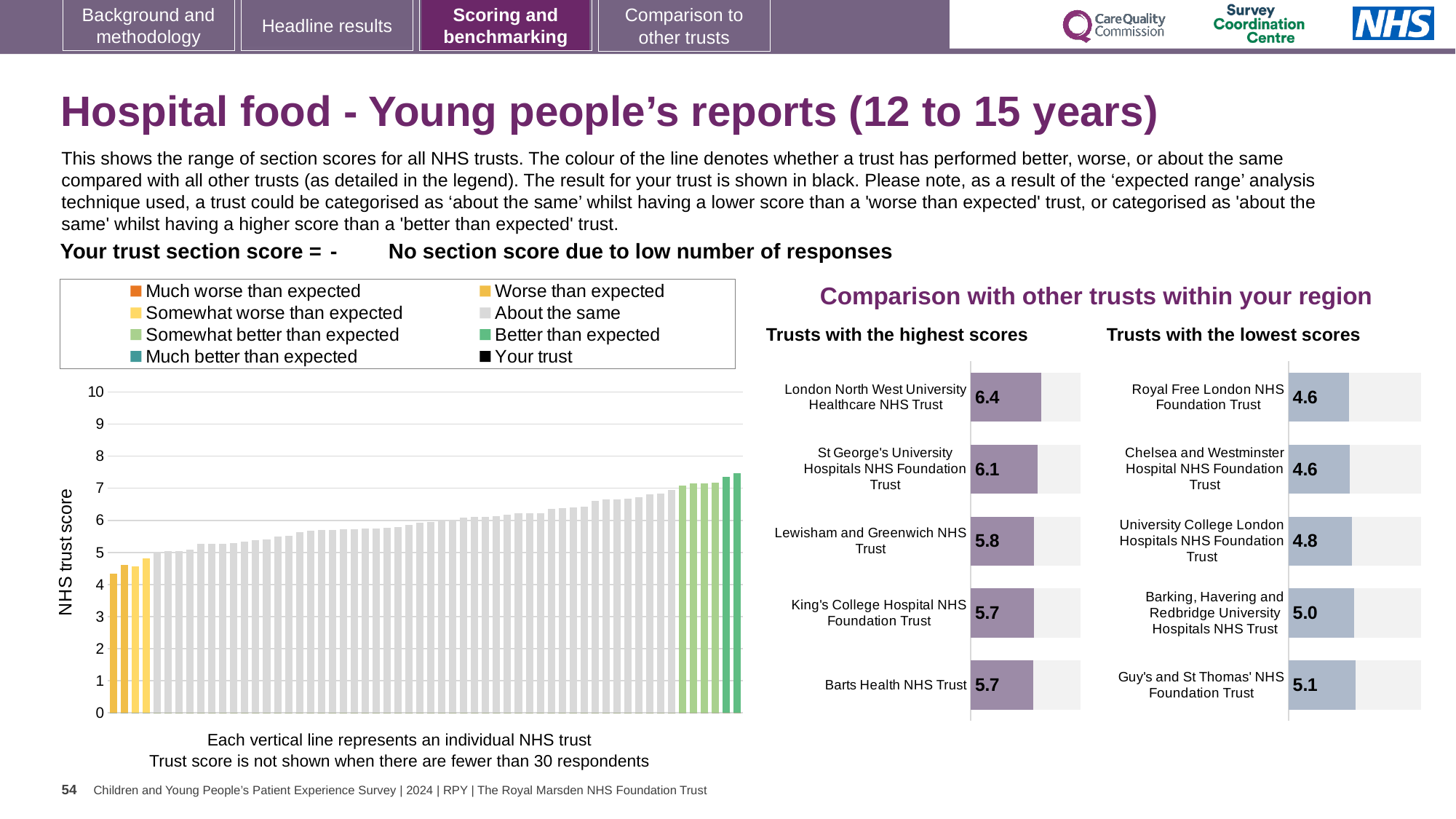
In the main 'NHS trust score' chart on the left, is the value of the tallest bar greater or less than 7? greater In the main 'NHS trust score' chart on the left, is the value of the shortest bar greater or less than 5? less How many entries does the legend of the main 'NHS trust score' chart list? 8 In the 'Trusts with the highest scores' chart, what is the score for London North West University Healthcare NHS Trust? 6.4 In the 'Trusts with the highest scores' chart, which trust has the highest score? London North West University Healthcare NHS Trust In the 'Trusts with the lowest scores' chart, what is the difference between the scores of Guy's and St Thomas' NHS Foundation Trust and Royal Free London NHS Foundation Trust? 0.5 In the 'Trusts with the lowest scores' chart, what is the score for University College London Hospitals NHS Foundation Trust? 4.8 In the 'Trusts with the highest scores' chart, which has the higher score: St George's University Hospitals NHS Foundation Trust or Lewisham and Greenwich NHS Trust? St George's University Hospitals NHS Foundation Trust How many trusts are listed in the 'Trusts with the lowest scores' chart? 5 In the 'Trusts with the highest scores' chart, what is the difference between the scores of London North West University Healthcare NHS Trust and Barts Health NHS Trust? 0.7 In the 'Trusts with the lowest scores' chart, which trust has the highest score shown? Guy's and St Thomas' NHS Foundation Trust In the main 'NHS trust score' chart on the left, do the bar values rise or fall from left to right? rise